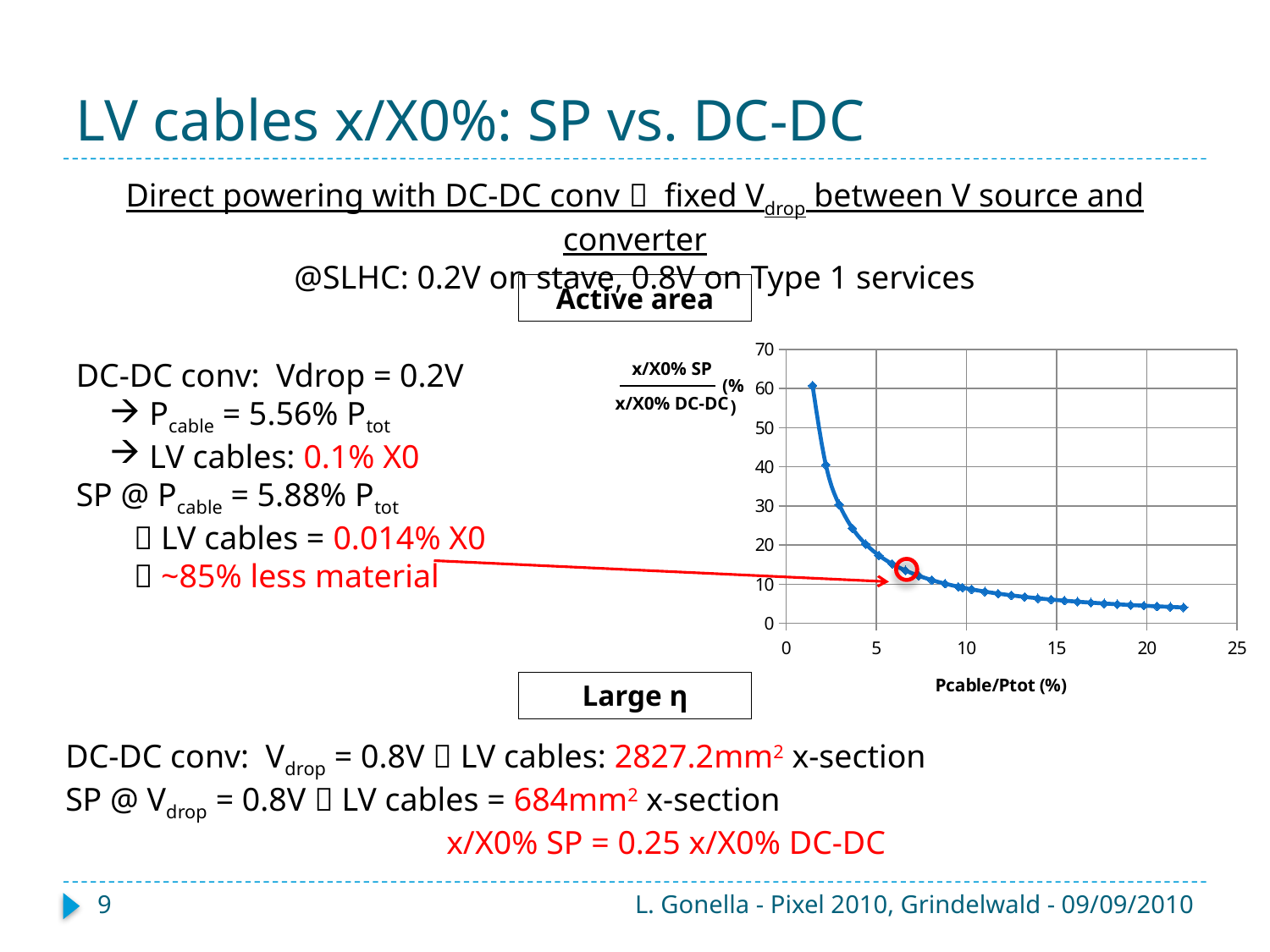
Is the plotted value at Pcable/Ptot = 15% greater or less than 10? less What is the maximum value shown on the y axis of the chart? 70 Is the plotted value at Pcable/Ptot = 20% greater or less than 10? less Is the plotted value at Pcable/Ptot = 5% greater or less than 20? less Do the plotted values rise or fall as Pcable/Ptot (%) increases? fall What kind of chart is shown on the slide? line chart What is the label of the x axis of the chart? Pcable/Ptot (%)